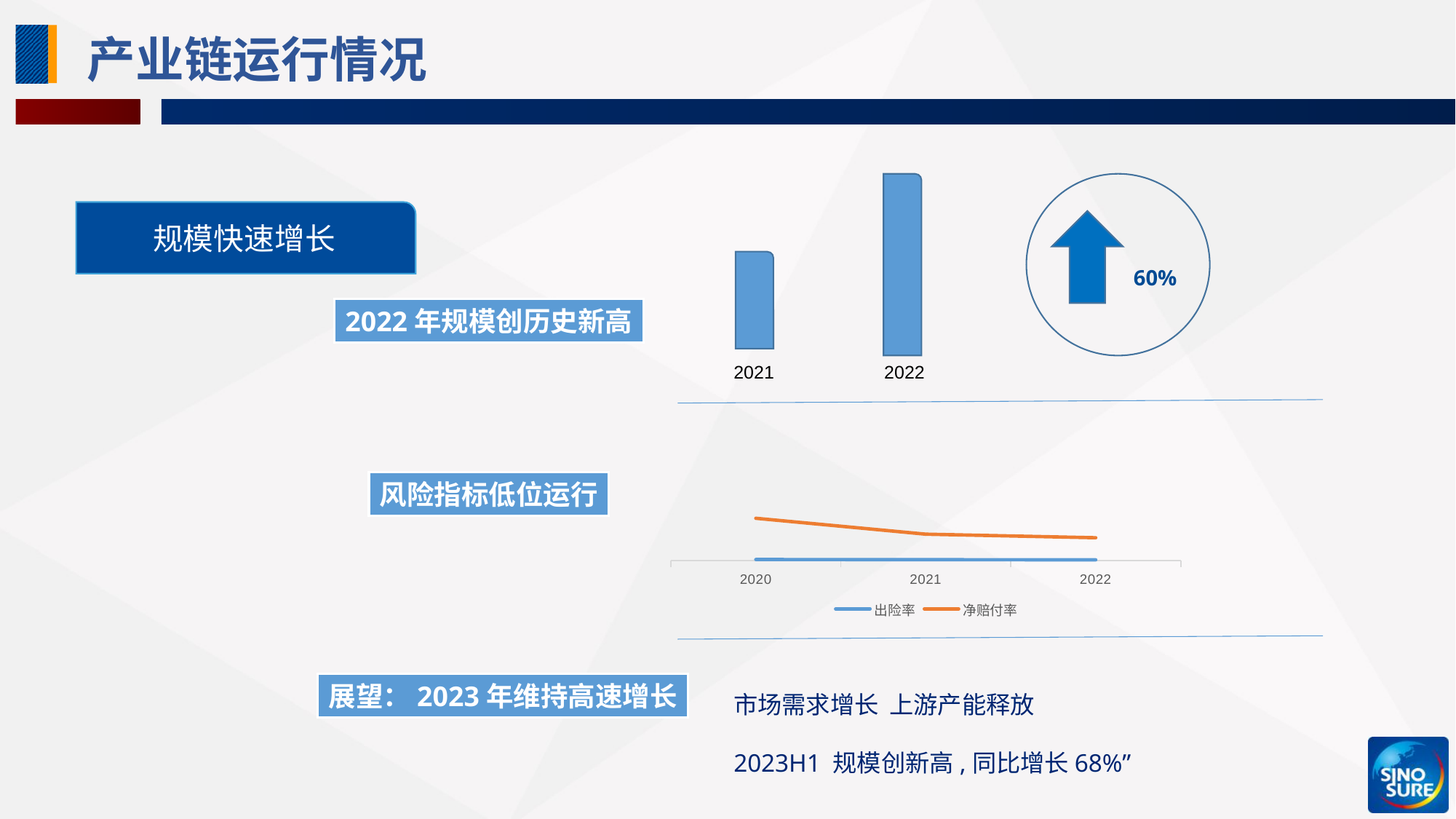
In the upper bar chart, how many bars are plotted? 2 In the upper bar chart, is the bar for 2022 taller or shorter than the bar for 2021? taller What kind of chart is the upper chart with the years 2021 and 2022? bar chart In the upper bar chart, do the bars rise or fall from 2021 to 2022? rise In the lower line chart, how many years are shown on the x axis? 3 In the lower line chart, what colour is the 净赔付率 line? orange In the lower line chart, how many series does the legend list? 2 In the upper bar chart, which year has the shorter bar? 2021 In the lower line chart, does the 净赔付率 line rise or fall from 2020 to 2022? fall In the lower line chart, which series is plotted higher, 出险率 or 净赔付率? 净赔付率 What kind of chart is the lower chart with the years 2020 to 2022? line chart In the upper bar chart, which year has the taller bar? 2022